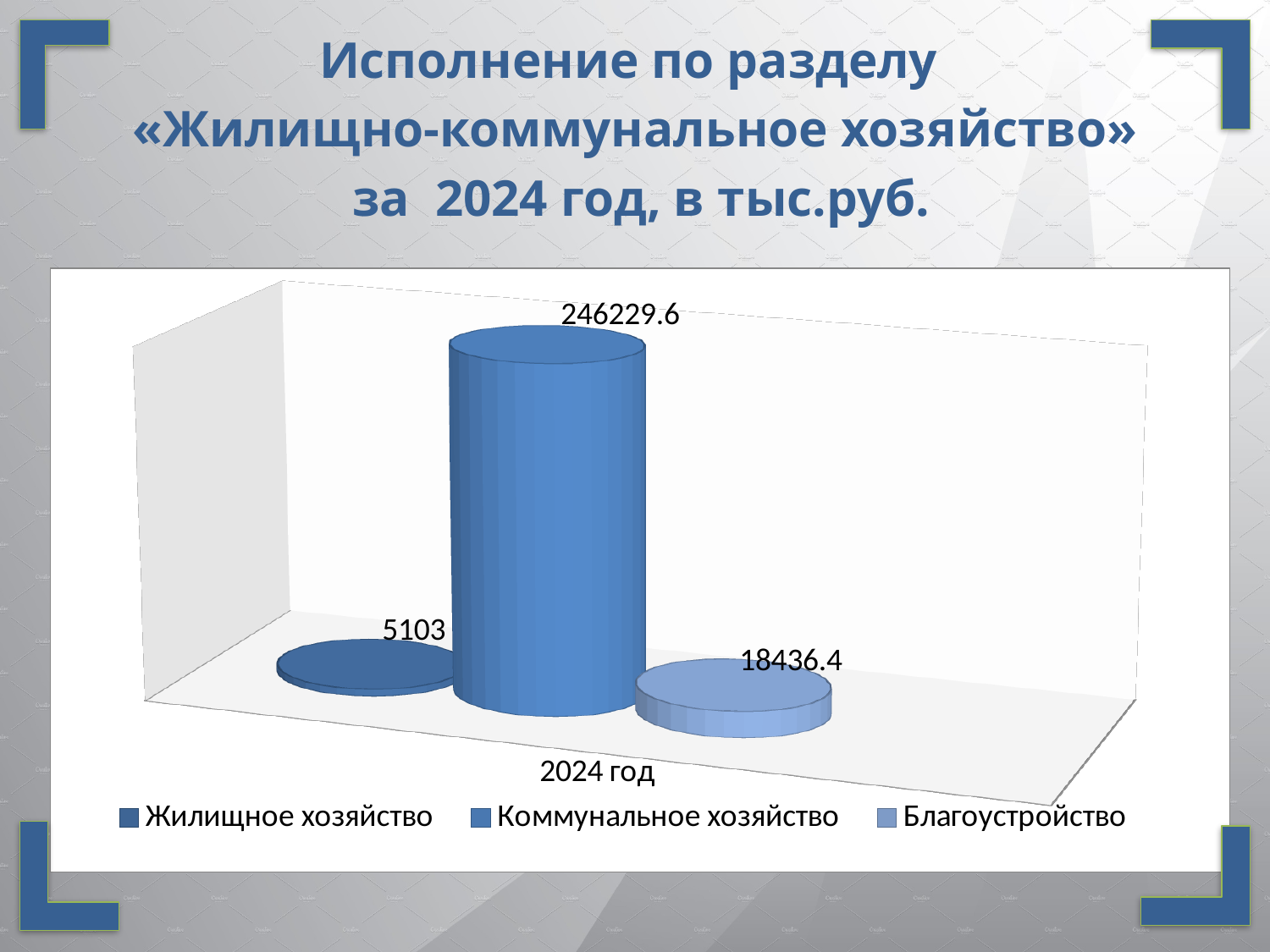
Which series has the highest value? Коммунальное хозяйство What category label is shown on the x axis? 2024 год What kind of chart is shown on the slide? Bar chart What unit is stated in the chart title? тыс.руб. What is the value for Жилищное хозяйство? 5103 What is the difference between the values for Коммунальное хозяйство and Благоустройство? 227793.2 Which is larger, the value for Благоустройство or the value for Жилищное хозяйство? Благоустройство What is the value for Благоустройство? 18436.4 What is the difference between the values for Благоустройство and Жилищное хозяйство? 13333.4 What is the value for Коммунальное хозяйство? 246229.6 How many series does the legend list? 3 Which series has the lowest value? Жилищное хозяйство